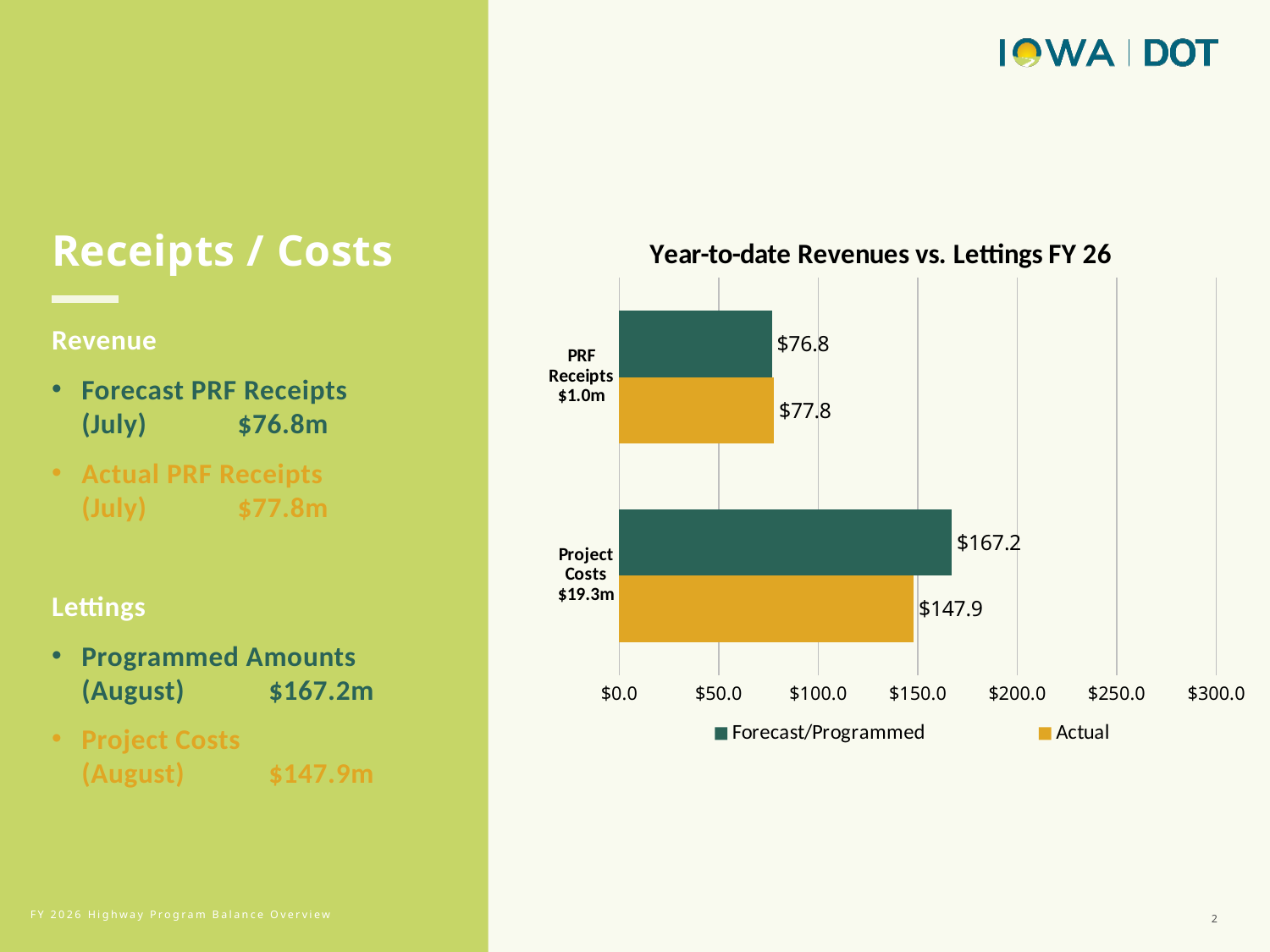
Which category has the highest Forecast/Programmed value? Project Costs What is the Actual value for PRF Receipts? $77.8 What is the title of the chart? Year-to-date Revenues vs. Lettings FY 26 What is the difference between the Forecast/Programmed and Actual values for Project Costs? $19.3 What is the Actual value for Project Costs? $147.9 How many series does the legend list? 2 What kind of chart is shown on the slide? Bar chart What is the Forecast/Programmed value for Project Costs? $167.2 Which category has the lowest Actual value? PRF Receipts Is the Actual value for Project Costs greater or less than $100.0? greater What is the Forecast/Programmed value for PRF Receipts? $76.8 Which is larger for PRF Receipts, the Forecast/Programmed value or the Actual value? Actual